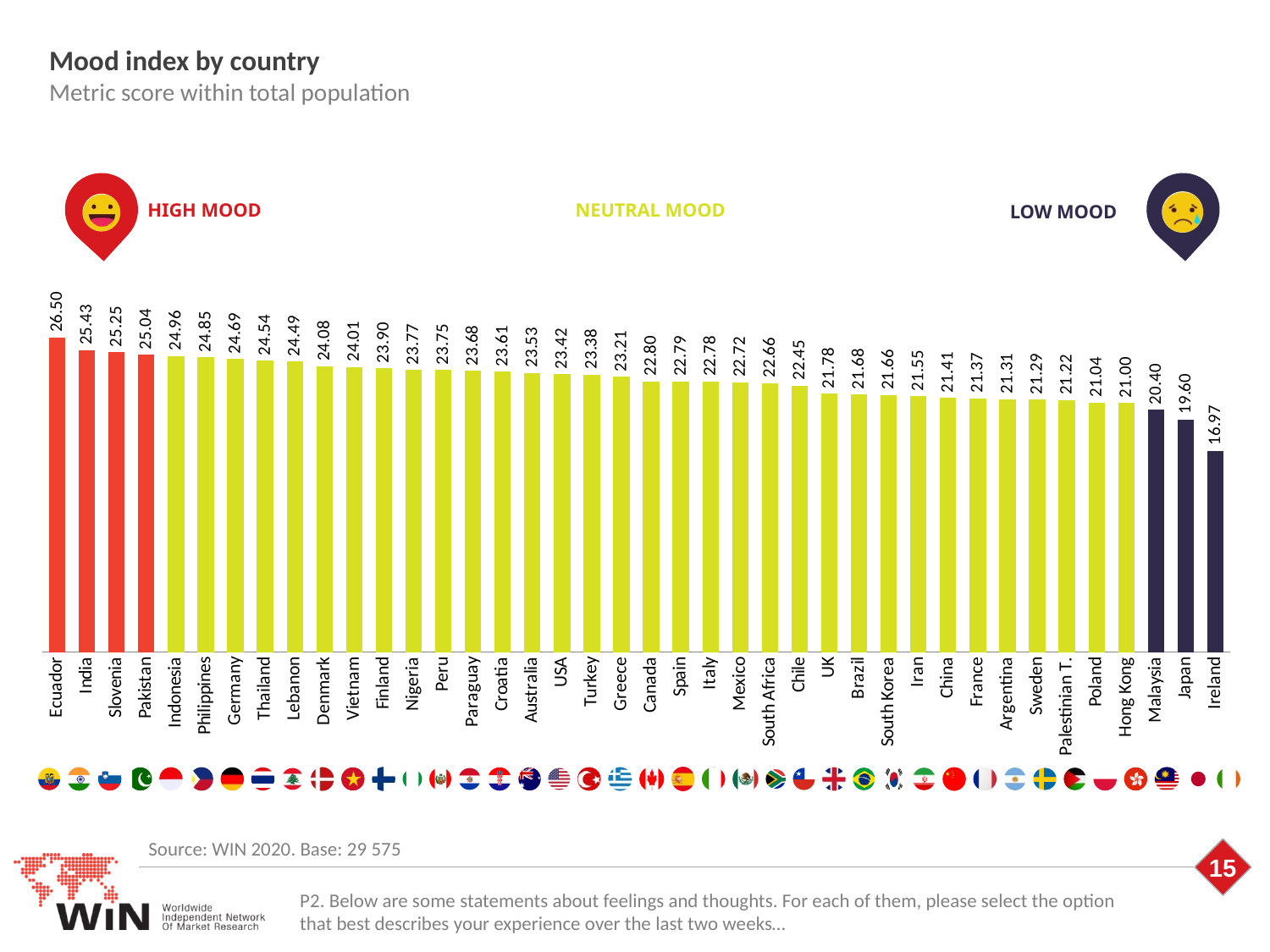
What is the mood index value for Ecuador? 26.50 What is the mood index value for Germany? 24.69 What is the difference between the mood index of India and Malaysia? 5.03 Which mood group are the red bars labelled as? HIGH MOOD Which country has the lowest mood index? Ireland How many countries are shown in the chart? 40 What is the difference between the mood index of Ecuador and Ireland? 9.53 Which country has the highest mood index? Ecuador Which has a higher mood index, Finland or Hong Kong? Finland What is the mood index value for Japan? 19.60 Do the values rise or fall moving from left to right along the x axis? Fall What type of chart is used to show the mood index by country? Bar chart